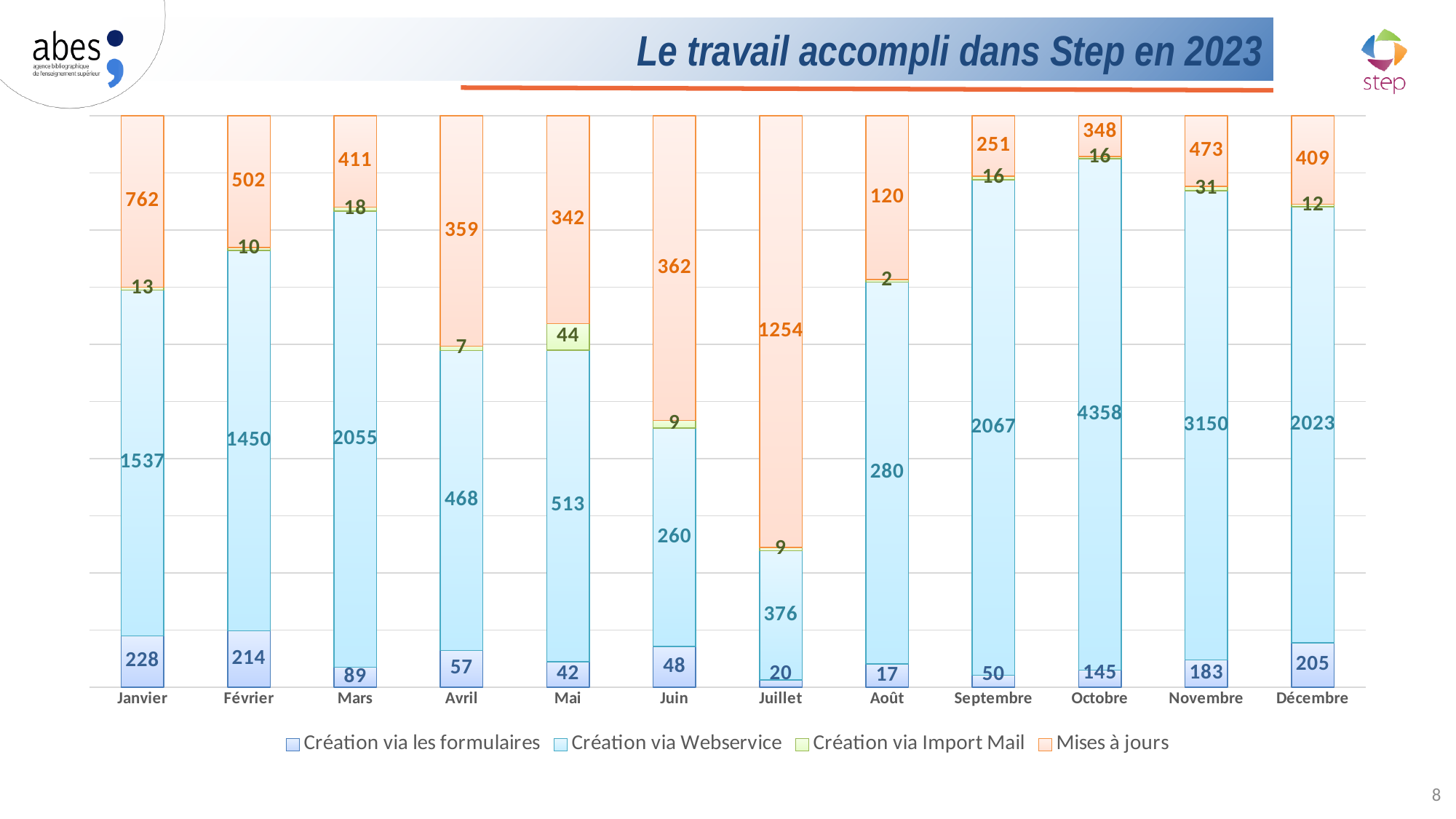
Which month has the larger Création via Webservice value, Novembre or Décembre? Novembre What kind of chart is shown on the slide? Stacked bar chart What is the total of all four series for Janvier? 2540 What is the difference between the Mises à jours values for Janvier and Février? 260 Which month has the highest value for Création via Webservice? Octobre Which month has the highest value for Mises à jours? Juillet How many months are shown on the x axis? 12 What is the value of Création via Webservice for Octobre? 4358 How many series does the legend list? 4 What is the value of Création via Import Mail for Mai? 44 Which month has the lowest value for Création via les formulaires? Août What is the value of Mises à jours for Juillet? 1254